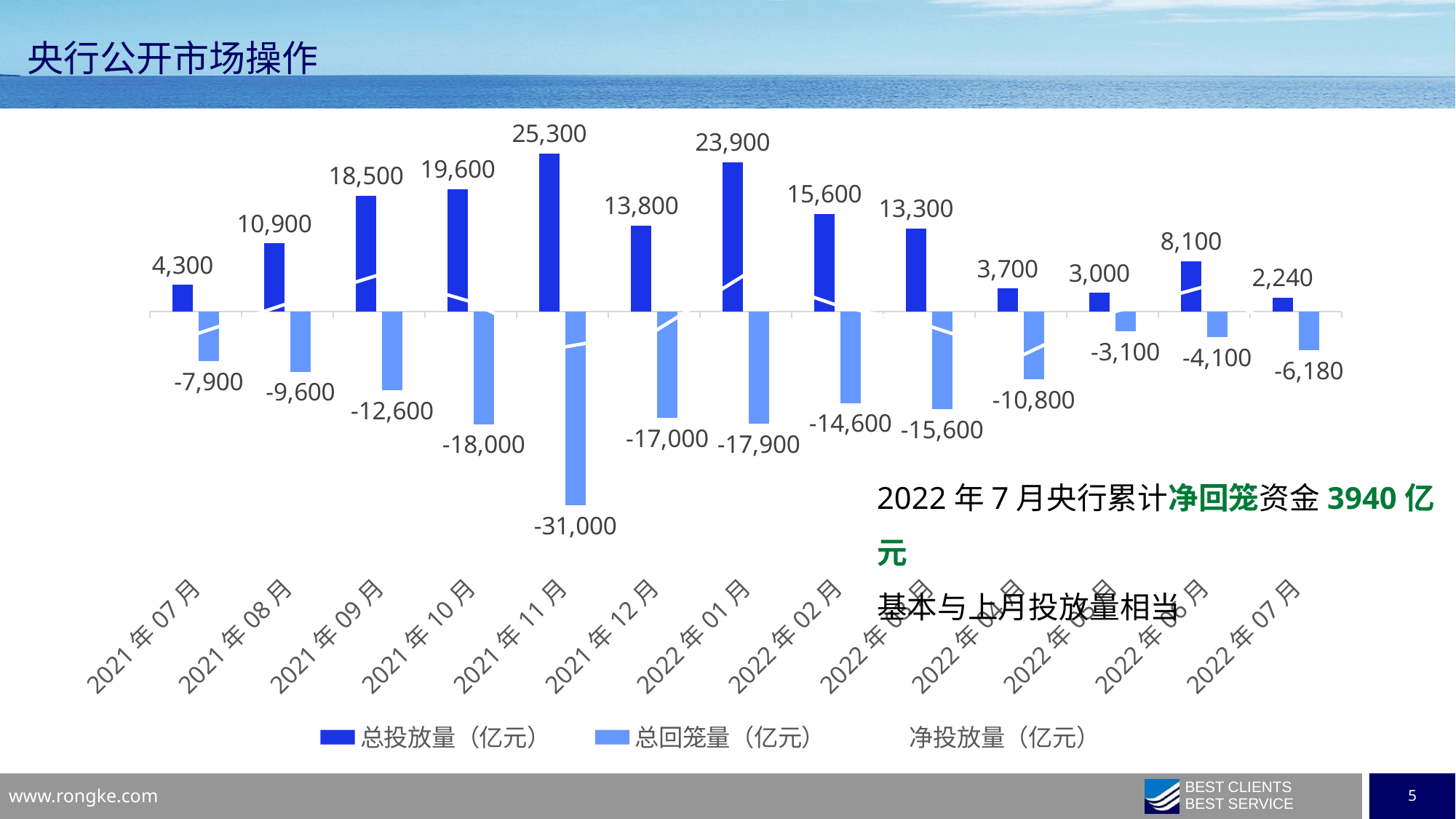
How many months are shown on the x axis of the chart? 13 What kind of chart is shown on the slide? bar chart What is the 总回笼量（亿元） value for 2022年07月? -6,180 What is the 总投放量（亿元） value for 2021年11月? 25,300 Which month has the highest 总投放量（亿元）? 2021年11月 What is the title of the slide? 央行公开市场操作 What is the sum of 总投放量（亿元） and 总回笼量（亿元） for 2022年01月? 6,000 Which month has the lowest 总投放量（亿元）? 2022年07月 How much larger is the 总投放量（亿元） for 2021年11月 than for 2021年07月? 21,000 Which month has the larger 总投放量（亿元）, 2021年09月 or 2021年10月? 2021年10月 What is the 总回笼量（亿元） value for 2021年11月? -31,000 How many series does the chart legend list? 3